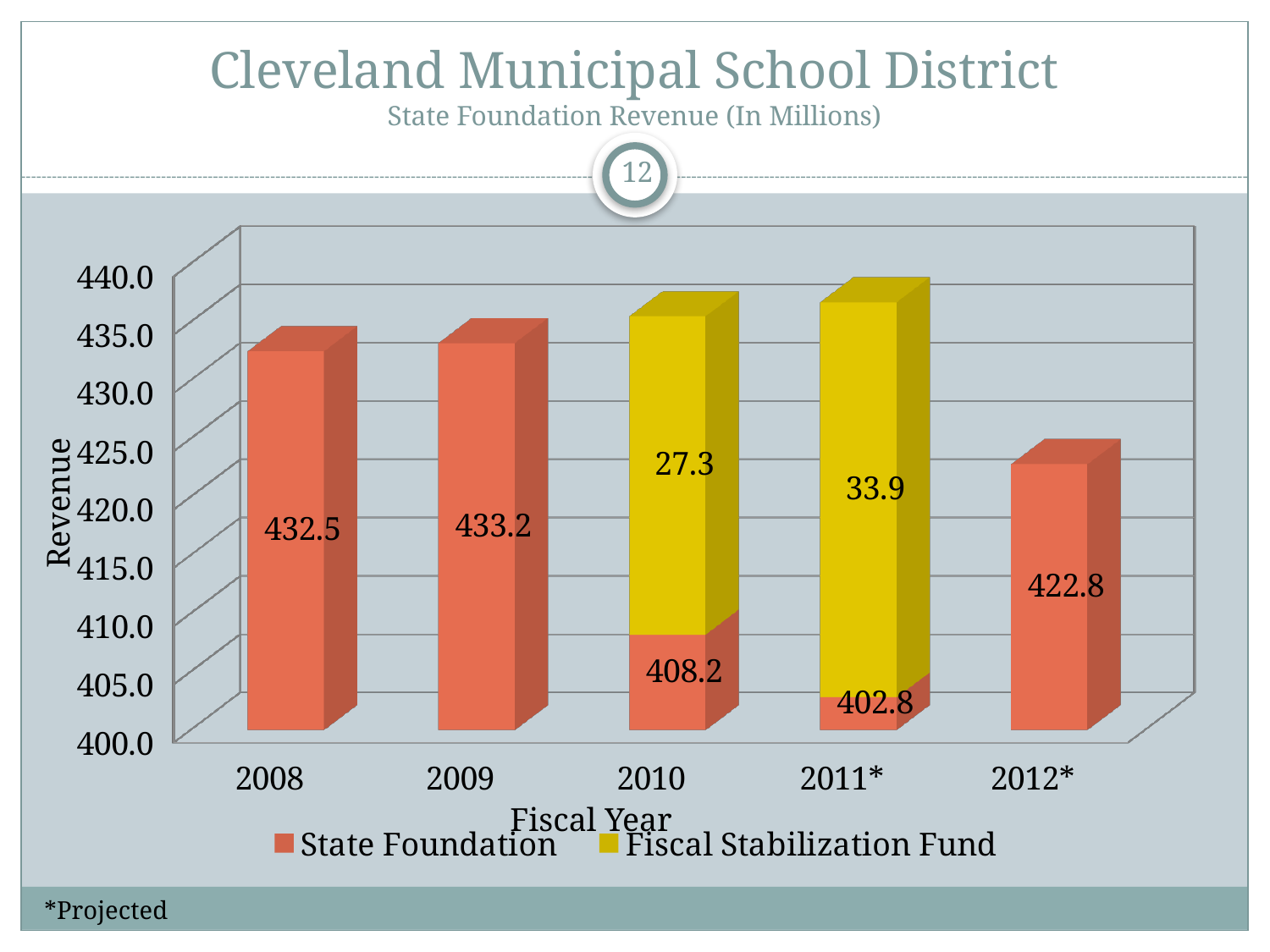
How much higher is the State Foundation revenue in 2009 than in 2008? 0.7 What is the Fiscal Stabilization Fund value for fiscal year 2011*? 33.9 What kind of chart is shown on the slide? Stacked bar chart What is the State Foundation revenue for fiscal year 2012*? 422.8 Which is larger, the State Foundation revenue for 2010 or for 2012*? 2012* How many fiscal years are shown on the x axis? 5 Which fiscal year has the lowest State Foundation revenue? 2011* What is the difference between the Fiscal Stabilization Fund values for 2011* and 2010? 6.6 What is the State Foundation revenue for fiscal year 2008? 432.5 How many series does the legend list? 2 What is the total of the stacked bar for fiscal year 2010? 435.5 Which fiscal year has the highest State Foundation revenue? 2009